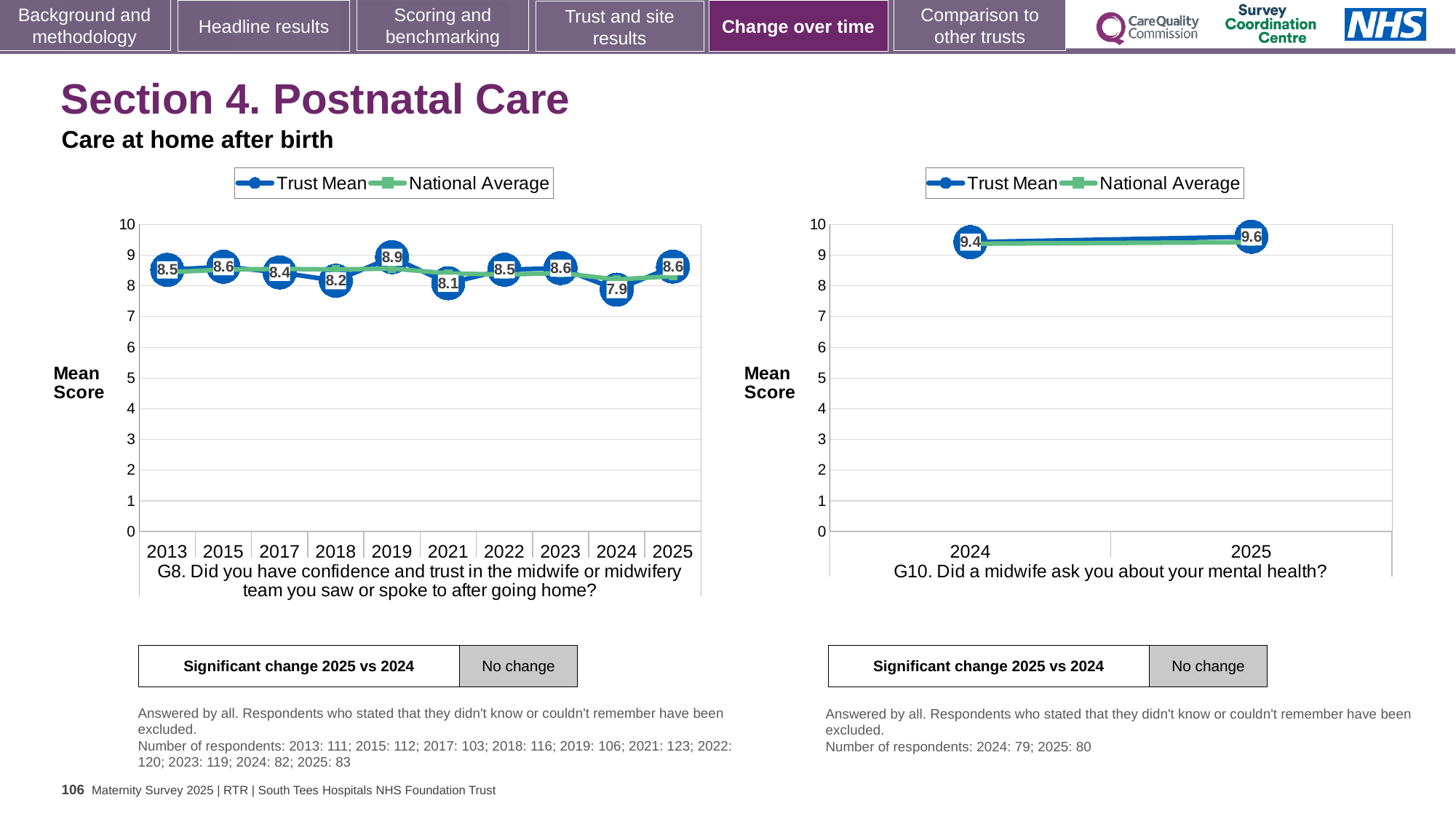
In the G10 chart (right), what is the Trust Mean for 2024? 9.4 In the G8 chart (left), what is the difference between the Trust Mean for 2019 and the Trust Mean for 2024? 1.0 In the G8 chart (left), which year has the highest Trust Mean? 2019 In the G10 chart (right), what is the Trust Mean for 2025? 9.6 In the G8 chart (left), what is the Trust Mean for 2025? 8.6 How many series does the legend of the G10 chart (right) list? 2 In the G8 chart (left), how many years are shown on the x axis? 10 In the G10 chart (right), does the Trust Mean rise or fall from 2024 to 2025? rise In the G8 chart (left), what is the Trust Mean for 2019? 8.9 In the G8 chart (left), which year has the lowest Trust Mean? 2024 In the G8 chart (left), what is the Trust Mean for 2024? 7.9 What kind of chart is the G8 chart (left)? line chart